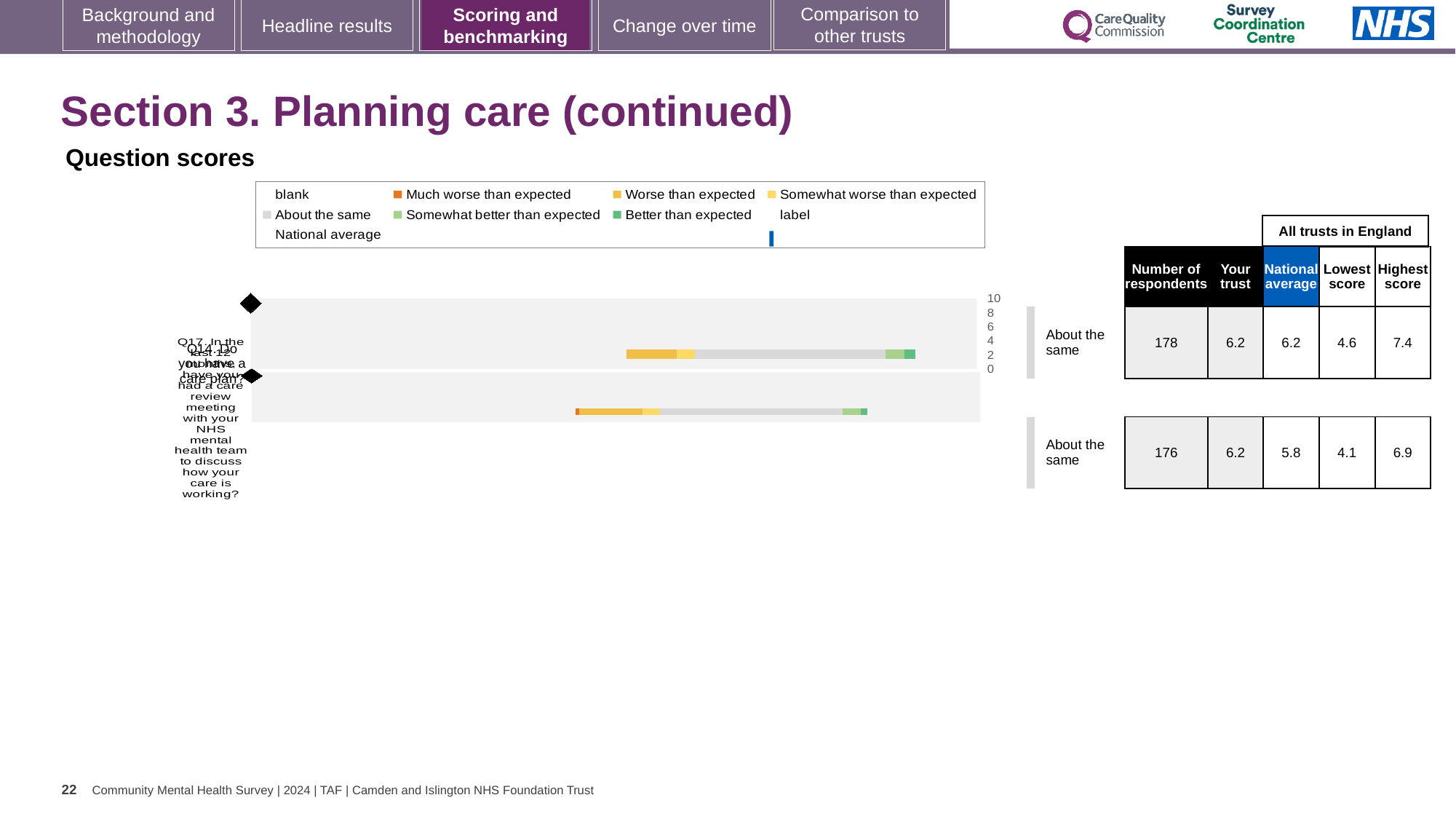
What is the national average for the bottom row of the table? 5.8 What kind of chart is shown under 'Question scores'? bar chart What colour is the 'National average' marker in the legend? blue What is the 'Your trust' score for the top row of the table? 6.2 What is the difference between the highest score and the lowest score in the top row of the table? 2.8 What is the lowest score among all trusts in England for the top row? 4.6 What benchmark category is shown for both questions in the chart? About the same How many questions (bars) are plotted in the chart? 2 In the table next to the chart, what is the number of respondents for the bottom row? 176 What is the highest score among all trusts in England for the bottom row? 6.9 In the table next to the chart, what is the number of respondents for the top row? 178 Which row has the higher national average, the top row or the bottom row? top row